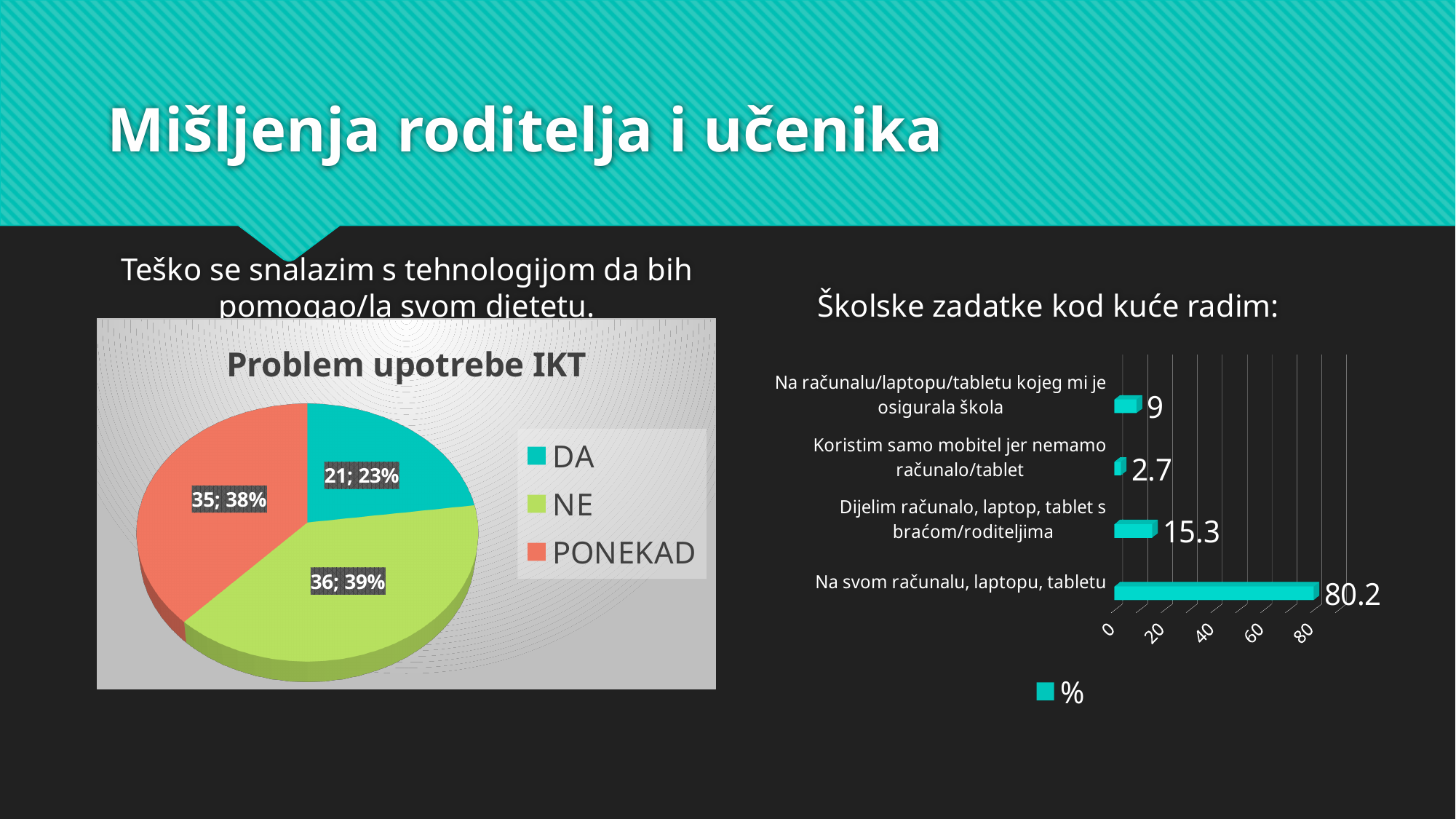
In the 'Problem upotrebe IKT' pie chart, which category has the smallest slice? DA In the 'Školske zadatke kod kuće radim:' chart, what is the value for 'Na svom računalu, laptopu, tabletu'? 80.2 In the 'Školske zadatke kod kuće radim:' chart, which category has the highest value? Na svom računalu, laptopu, tabletu In the 'Problem upotrebe IKT' pie chart, what is the difference between the counts for NE and DA? 15 In the 'Školske zadatke kod kuće radim:' chart, which is larger: 'Dijelim računalo, laptop, tablet s braćom/roditeljima' or 'Na računalu/laptopu/tabletu kojeg mi je osigurala škola'? Dijelim računalo, laptop, tablet s braćom/roditeljima What kind of chart is 'Školske zadatke kod kuće radim:'? Bar chart In the 'Problem upotrebe IKT' pie chart, how many categories does the legend list? 3 In the 'Školske zadatke kod kuće radim:' chart, what is the difference between the values for 'Dijelim računalo, laptop, tablet s braćom/roditeljima' and 'Na računalu/laptopu/tabletu kojeg mi je osigurala škola'? 6.3 In the 'Problem upotrebe IKT' pie chart, what value and percentage are shown for the DA slice? 21; 23% What kind of chart is 'Problem upotrebe IKT'? Pie chart In the 'Problem upotrebe IKT' pie chart, what share of the pie does NE have? 39% In the 'Školske zadatke kod kuće radim:' chart, what is the value for 'Koristim samo mobitel jer nemamo računalo/tablet'? 2.7